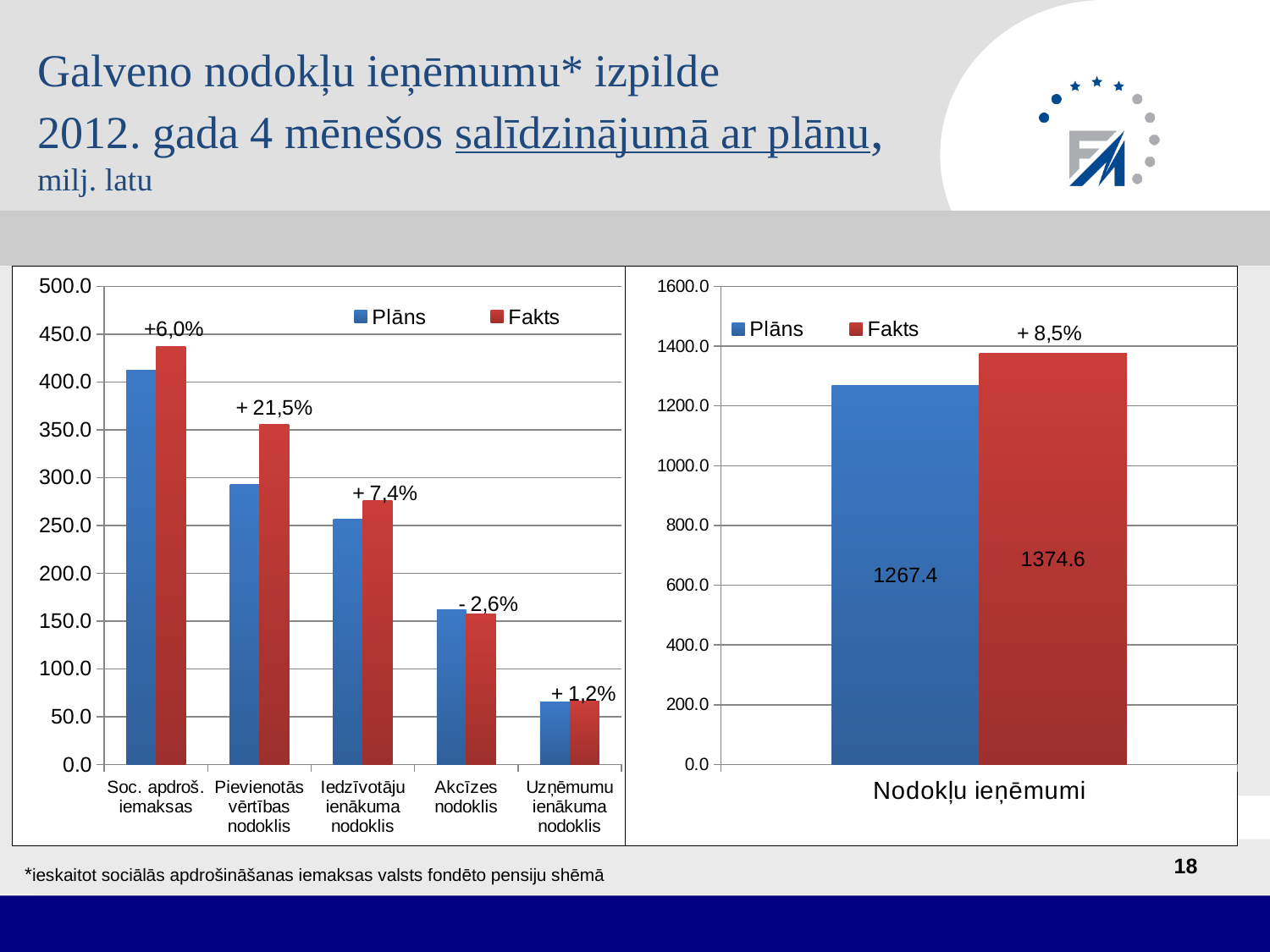
In the right chart (Nodokļu ieņēmumi), what percentage change is printed above the bars? + 8,5% In the right chart (Nodokļu ieņēmumi), what is the value for Plāns? 1267.4 In the left chart, which category has the highest bars? Soc. apdroš. iemaksas In the right chart (Nodokļu ieņēmumi), what is the value for Fakts? 1374.6 In the left chart, how many tax categories are shown on the x axis? 5 In the left chart, which category has the lowest bars? Uzņēmumu ienākuma nodoklis In the right chart (Nodokļu ieņēmumi), what is the difference between the Fakts and Plāns values? 107.2 In the left chart, how many series does the legend list? 2 In the left chart, what percentage label is printed above Pievienotās vērtības nodoklis? + 21,5% What kind of chart is the left chart? bar chart In the left chart, is the Plāns value for Soc. apdroš. iemaksas greater or less than 400? greater In the right chart (Nodokļu ieņēmumi), which is larger, Plāns or Fakts? Fakts